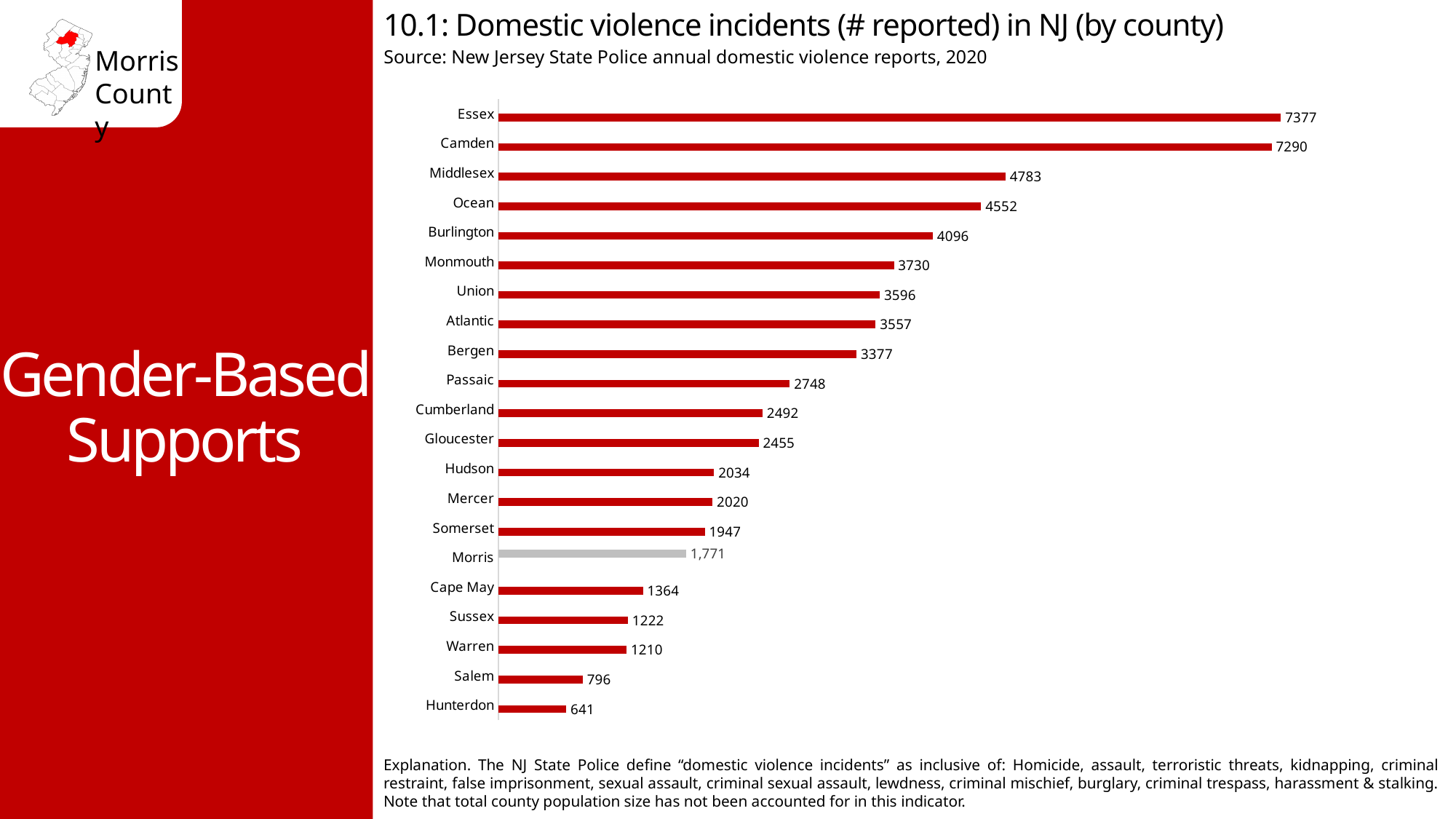
What is the difference between the number of incidents in Somerset and Morris? 176 Which county's bar is shown in grey instead of red? Morris What is the number of reported domestic violence incidents for Essex County? 7377 What is the number of reported domestic violence incidents for Cape May County? 1364 Which county has the lowest number of reported domestic violence incidents? Hunterdon Which county has more reported incidents, Middlesex or Ocean? Middlesex How many counties are shown in the chart? 21 What is the number of reported domestic violence incidents for Morris County? 1,771 Which county has the highest number of reported domestic violence incidents? Essex What is the number of reported domestic violence incidents for Bergen County? 3377 What type of chart is used to show domestic violence incidents by county? Bar chart What is the difference between the number of incidents in Essex and Camden? 87